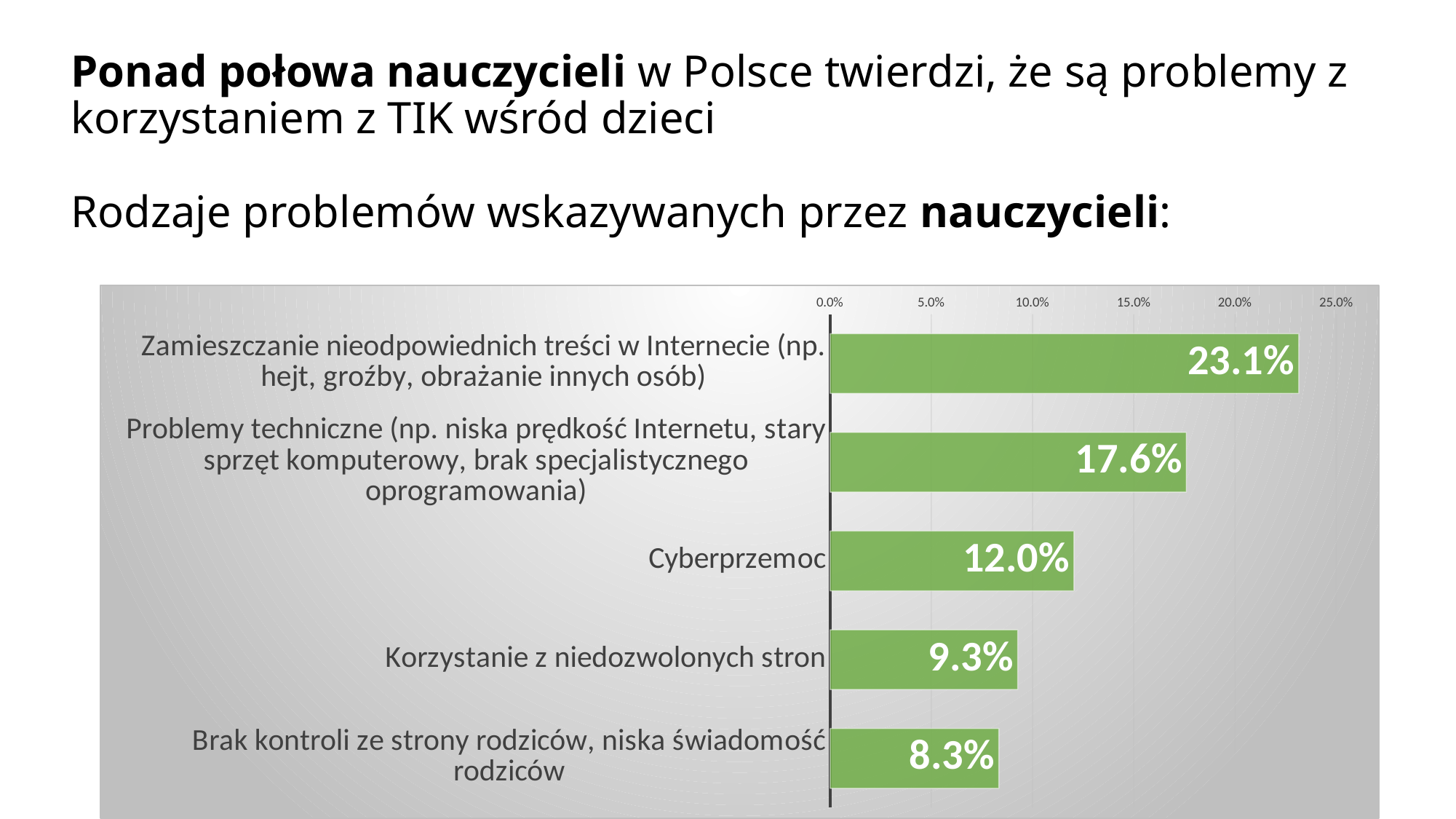
What is the value for Korzystanie z niedozwolonych stron? 9.3% Which category has the lowest value? Brak kontroli ze strony rodziców, niska świadomość rodziców Which is larger, the value for Cyberprzemoc or the value for Korzystanie z niedozwolonych stron? Cyberprzemoc Which category has the highest value? Zamieszczanie nieodpowiednich treści w Internecie (np. hejt, groźby, obrażanie innych osób) Is the value for Problemy techniczne greater or less than 15.0%? greater How many categories are shown in the chart? 5 What is the difference between the values for Zamieszczanie nieodpowiednich treści w Internecie and Problemy techniczne? 5.5% What is the value for Cyberprzemoc? 12.0% What kind of chart is shown on the slide? bar chart What is the value for Brak kontroli ze strony rodziców, niska świadomość rodziców? 8.3% What is the difference between the values for Cyberprzemoc and Korzystanie z niedozwolonych stron? 2.7% What is the value for Problemy techniczne (np. niska prędkość Internetu, stary sprzęt komputerowy, brak specjalistycznego oprogramowania)? 17.6%